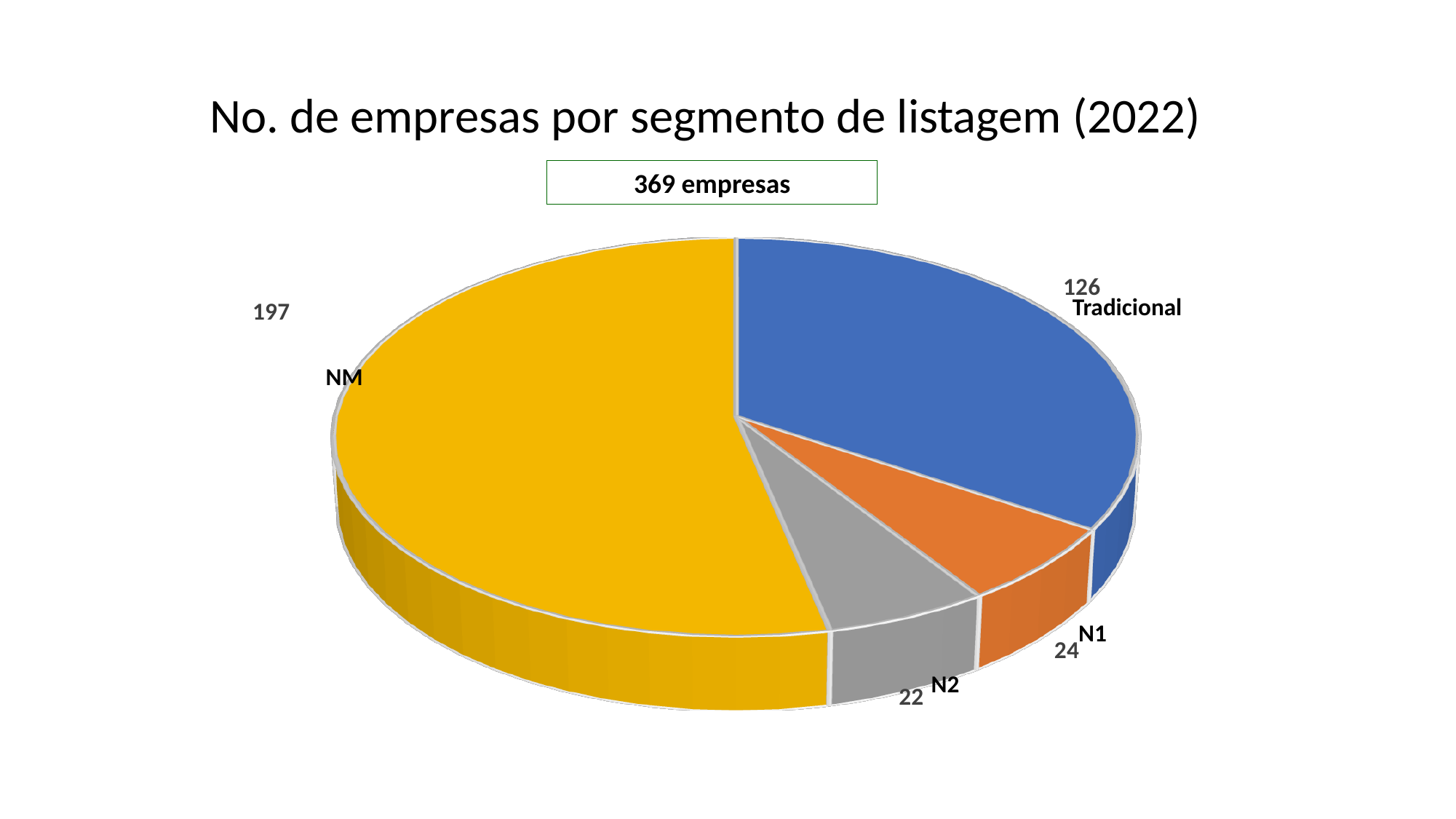
How many companies are in the N1 segment? 24 How many segments (slices) does the pie chart show? 4 How many companies are in the Tradicional segment? 126 What is the title of the chart? No. de empresas por segmento de listagem (2022) What is the difference between the number of companies in NM and in Tradicional? 71 What is the total number of companies shown in the box above the chart? 369 empresas How many companies are in the NM segment? 197 How many companies are in the N2 segment? 22 Which segment has more companies, N1 or Tradicional? Tradicional What type of chart is shown on the slide? Pie chart Which segment has the largest number of companies? NM Which segment has the smallest number of companies? N2